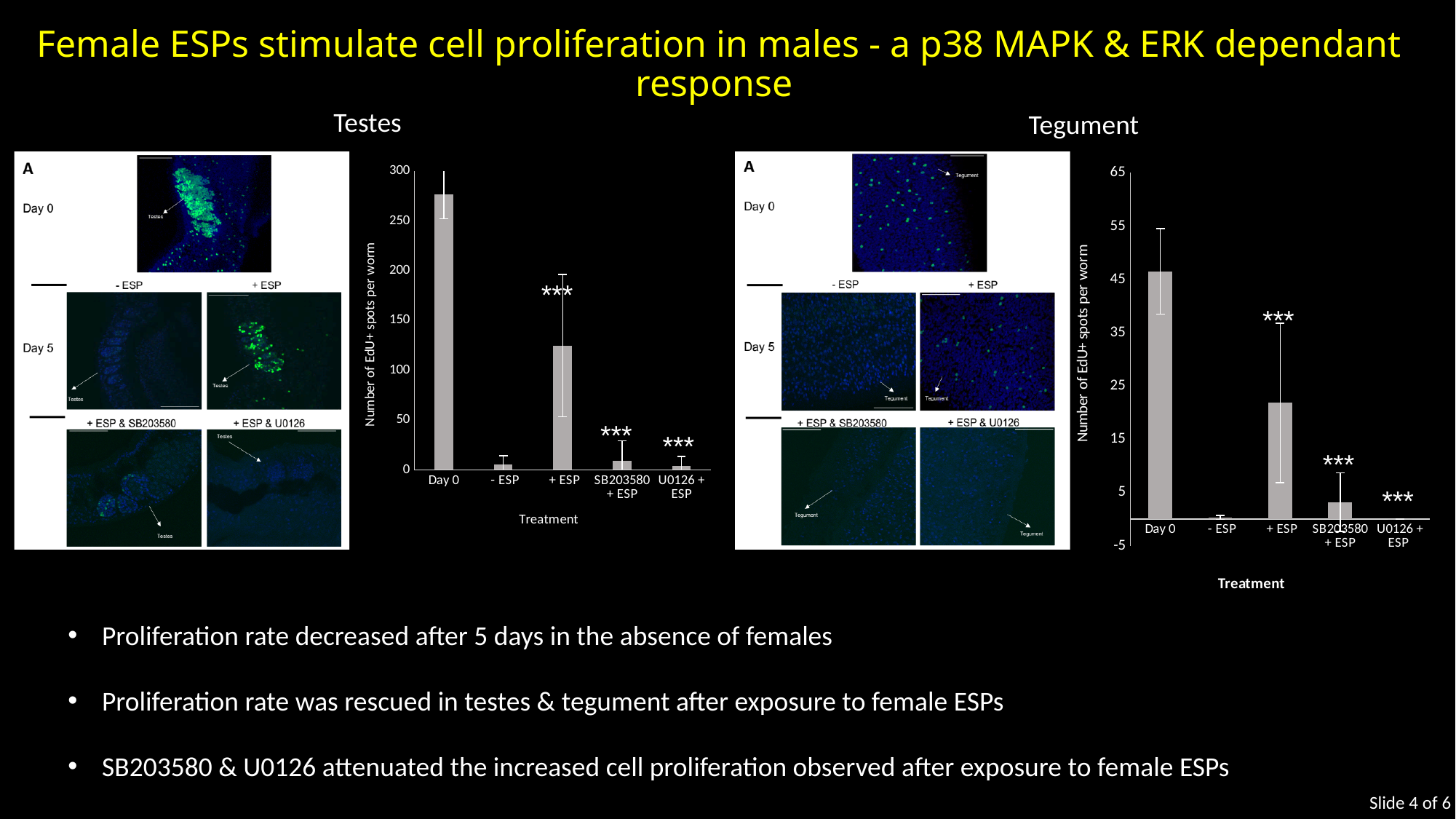
What is the y-axis label on the Tegument chart? Number of EdU+ spots per worm On the Testes chart, which treatment has the highest number of EdU+ spots per worm? Day 0 On the Tegument chart, is the value for Day 0 greater or less than 35? greater What kind of chart is the Testes chart? bar chart On the Testes chart, is the value for SB203580 + ESP greater or less than 50? less On the Tegument chart, which is larger, the value for + ESP or the value for SB203580 + ESP? + ESP On the Testes chart, which is larger, the value for - ESP or the value for + ESP? + ESP On the Testes chart, is the value for Day 0 greater or less than 250? greater How many treatment categories are shown on the Tegument chart? 5 On the Tegument chart, which treatment has the highest number of EdU+ spots per worm? Day 0